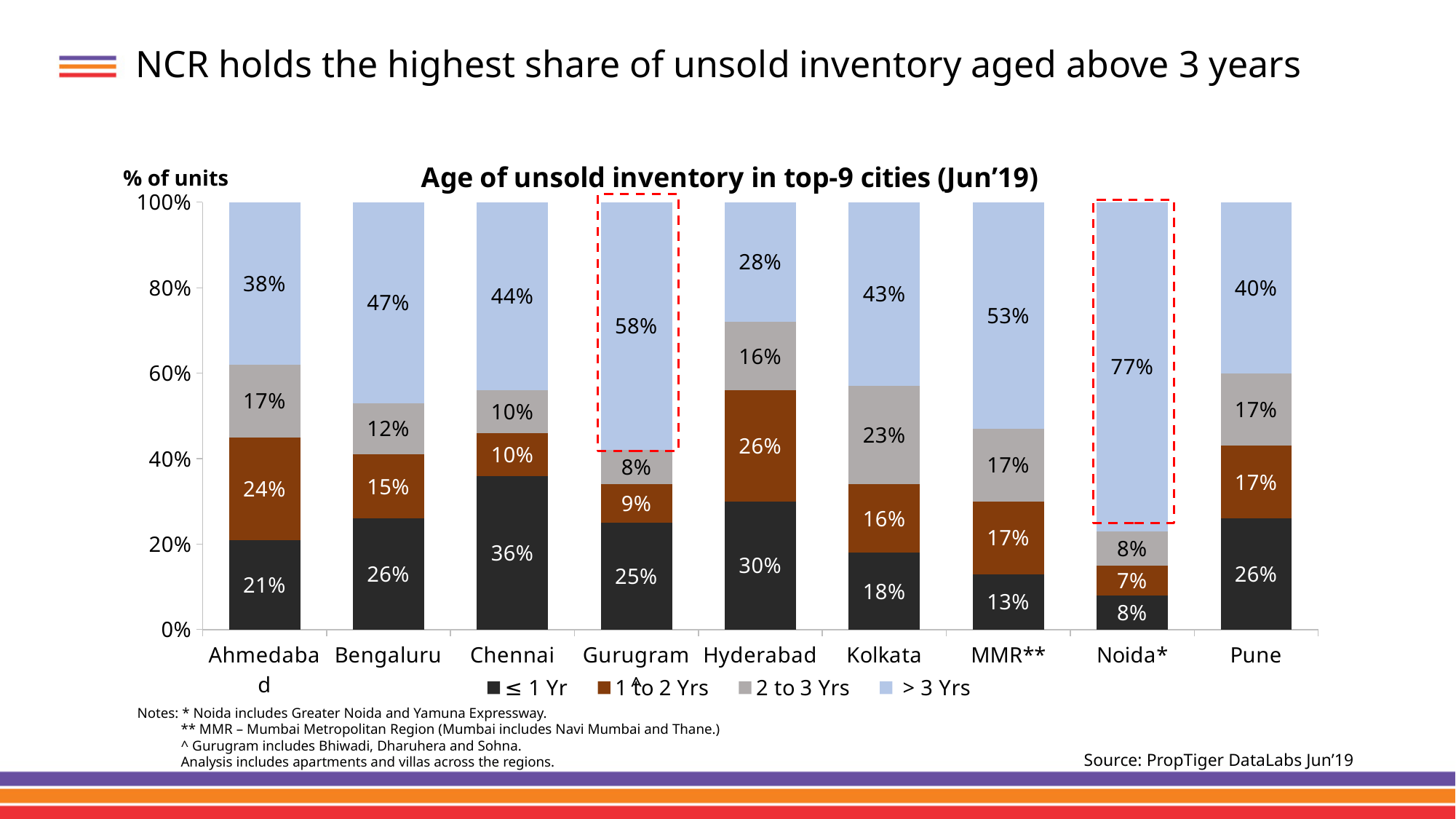
Which is larger: the '> 3 Yrs' share for Bengaluru or for Pune? Bengaluru Which city has the lowest '≤ 1 Yr' share? Noida* How many series does the legend list? 4 What is the value of the '≤ 1 Yr' segment for Chennai? 36% What type of chart is shown on the slide? Stacked bar chart What share of unsold inventory in Noida* is aged more than 3 years? 77% By how many percentage points does Noida*'s '> 3 Yrs' share exceed Gurugram's? 19 percentage points Which city has the lowest share of unsold inventory aged more than 3 years? Hyderabad What is the '2 to 3 Yrs' value for Kolkata? 23% What share of Hyderabad's unsold inventory is aged 1 to 2 years? 26% How many cities are shown on the x axis of the chart? 9 Which city has the highest share of unsold inventory aged more than 3 years? Noida*